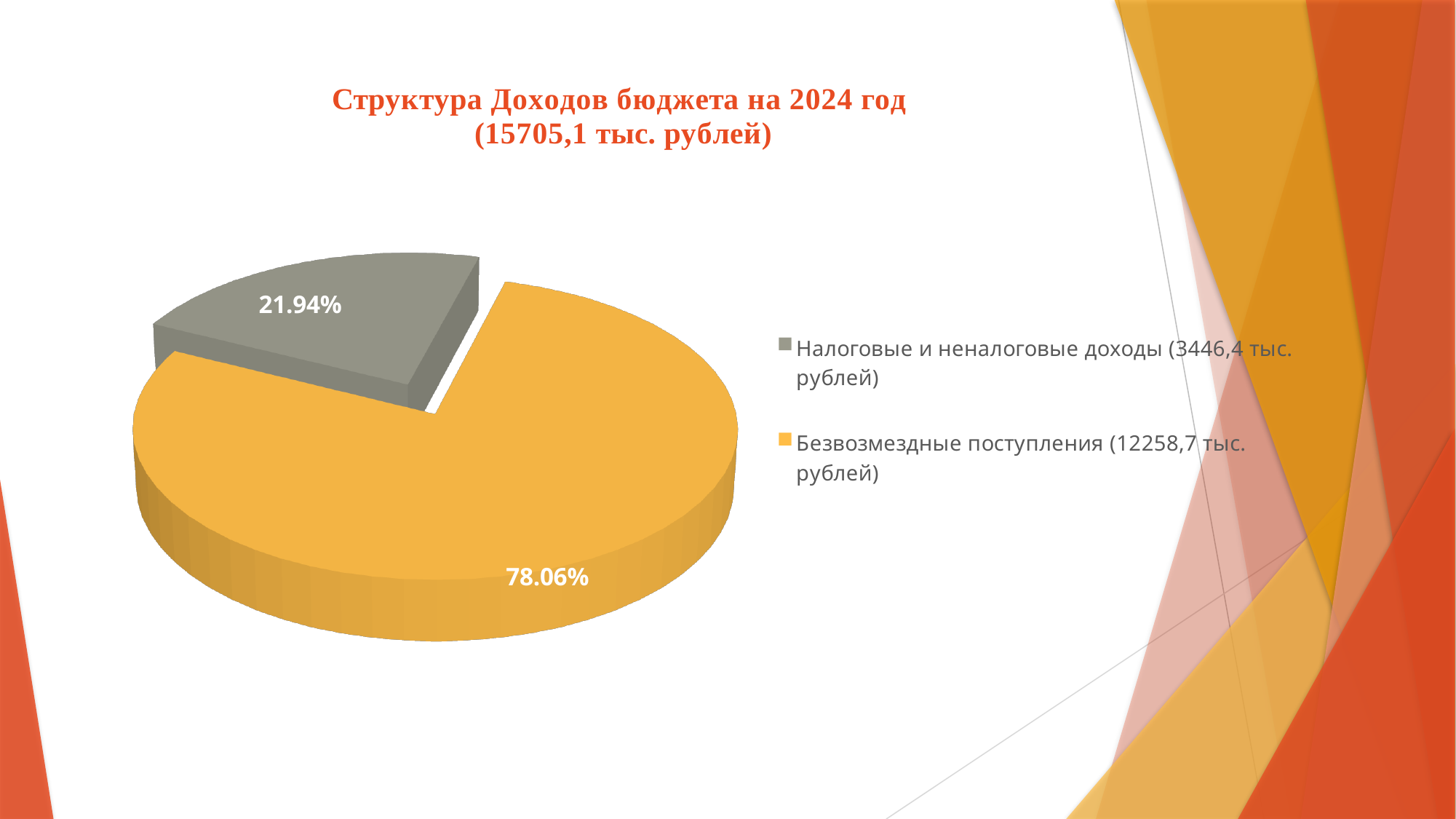
What colour is the slice for "Налоговые и неналоговые доходы"? grey Which category has the largest slice of the pie? Безвозмездные поступления Which category has the smallest slice of the pie? Налоговые и неналоговые доходы What kind of chart is shown on the slide? pie chart What share of the pie does "Безвозмездные поступления" represent? 78.06% How many slices does the pie chart have? 2 What amount in thousand rubles does the legend give for "Безвозмездные поступления"? 12258,7 тыс. рублей What share of the pie does "Налоговые и неналоговые доходы" represent? 21.94% What is the title of the chart? Структура Доходов бюджета на 2024 год (15705,1 тыс. рублей) What is the difference in percentage points between the two slices? 56.12 How many entries does the legend list? 2 Which is larger: the share for "Безвозмездные поступления" or the share for "Налоговые и неналоговые доходы"? Безвозмездные поступления